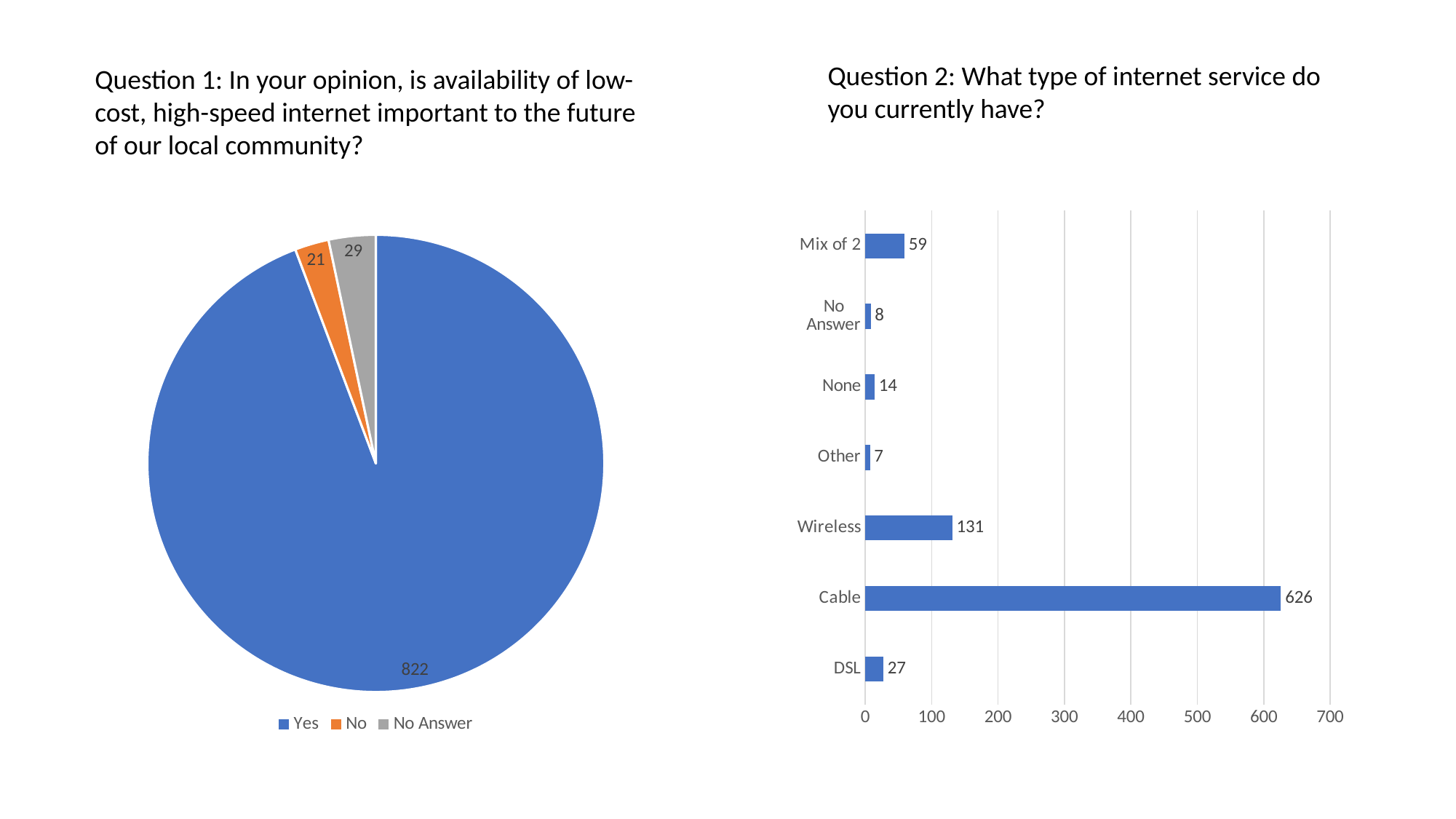
In the Question 2 chart, what is the difference between Cable and Wireless? 495 In the Question 1 pie chart, which category has the smallest slice? No In the Question 1 pie chart, what is the difference between the No Answer and No values? 8 In the Question 2 chart, which category has the highest value? Cable What kind of chart is used for Question 2? bar chart In the Question 2 chart, what is the value for Wireless? 131 In the Question 2 chart, which category has the lowest value? Other In the Question 1 pie chart, how many entries does the legend list? 3 In the Question 2 chart, how many categories are shown? 7 In the Question 1 pie chart, how many respondents answered Yes? 822 In the Question 2 chart, which is larger, Mix of 2 or DSL? Mix of 2 In the Question 1 pie chart, how many respondents answered No? 21